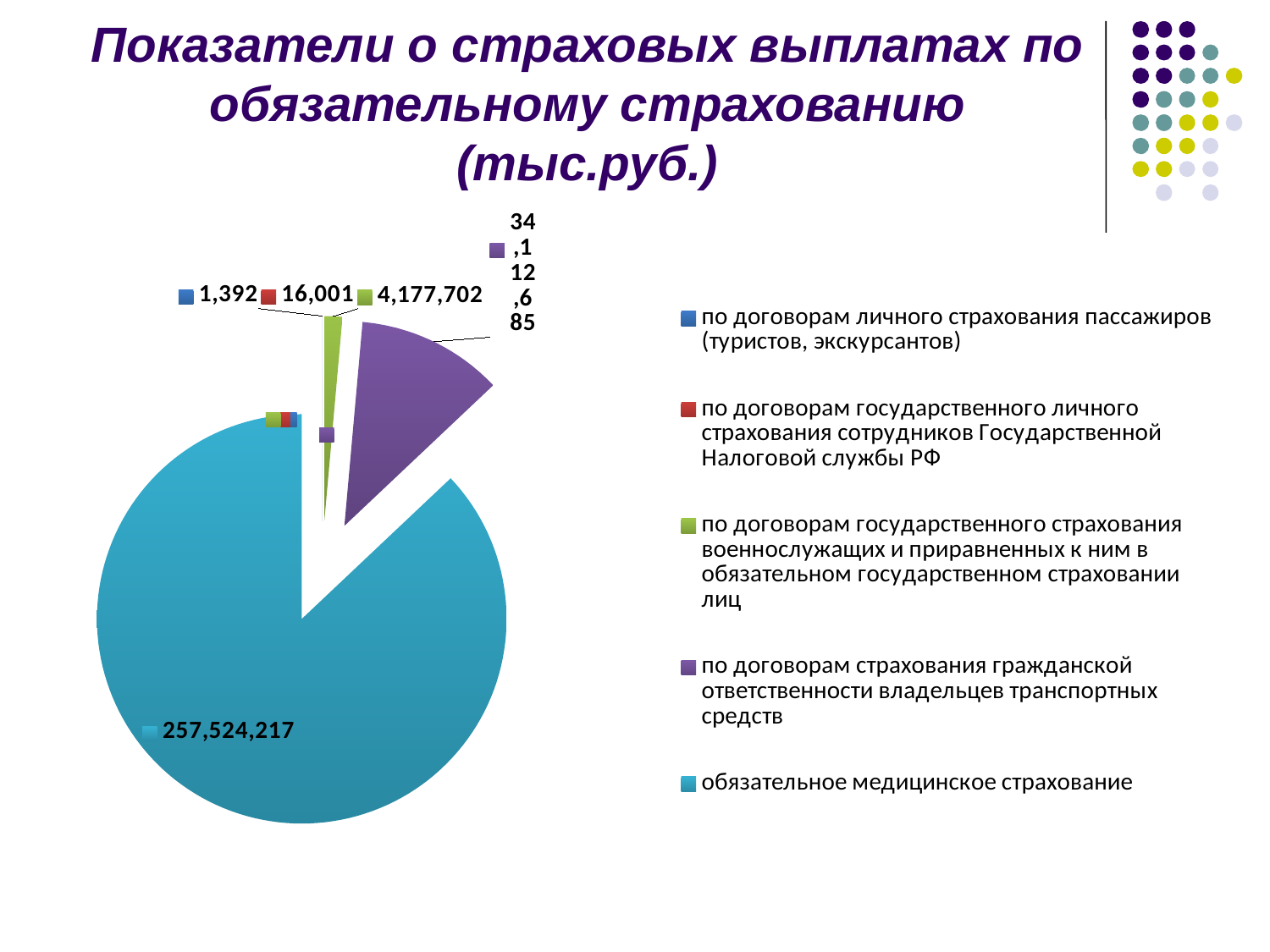
Which category has the largest slice of the pie? обязательное медицинское страхование What is the value for по договорам личного страхования пассажиров (туристов, экскурсантов)? 1,392 How many entries does the legend list? 5 What unit is given in the chart title? тыс.руб. How many slices does the pie chart have? 5 Which is larger: the value for по договорам страхования гражданской ответственности владельцев транспортных средств or the value for по договорам государственного страхования военнослужащих? по договорам страхования гражданской ответственности владельцев транспортных средств What is the value for обязательное медицинское страхование? 257,524,217 Which category has the smallest value? по договорам личного страхования пассажиров (туристов, экскурсантов) What is the value for по договорам государственного личного страхования сотрудников Государственной Налоговой службы РФ? 16,001 What is the value for по договорам государственного страхования военнослужащих и приравненных к ним в обязательном государственном страховании лиц? 4,177,702 What is the difference between the value for по договорам государственного личного страхования сотрудников Государственной Налоговой службы РФ and the value for по договорам личного страхования пассажиров (туристов, экскурсантов)? 14,609 What type of chart is shown on the slide? pie chart